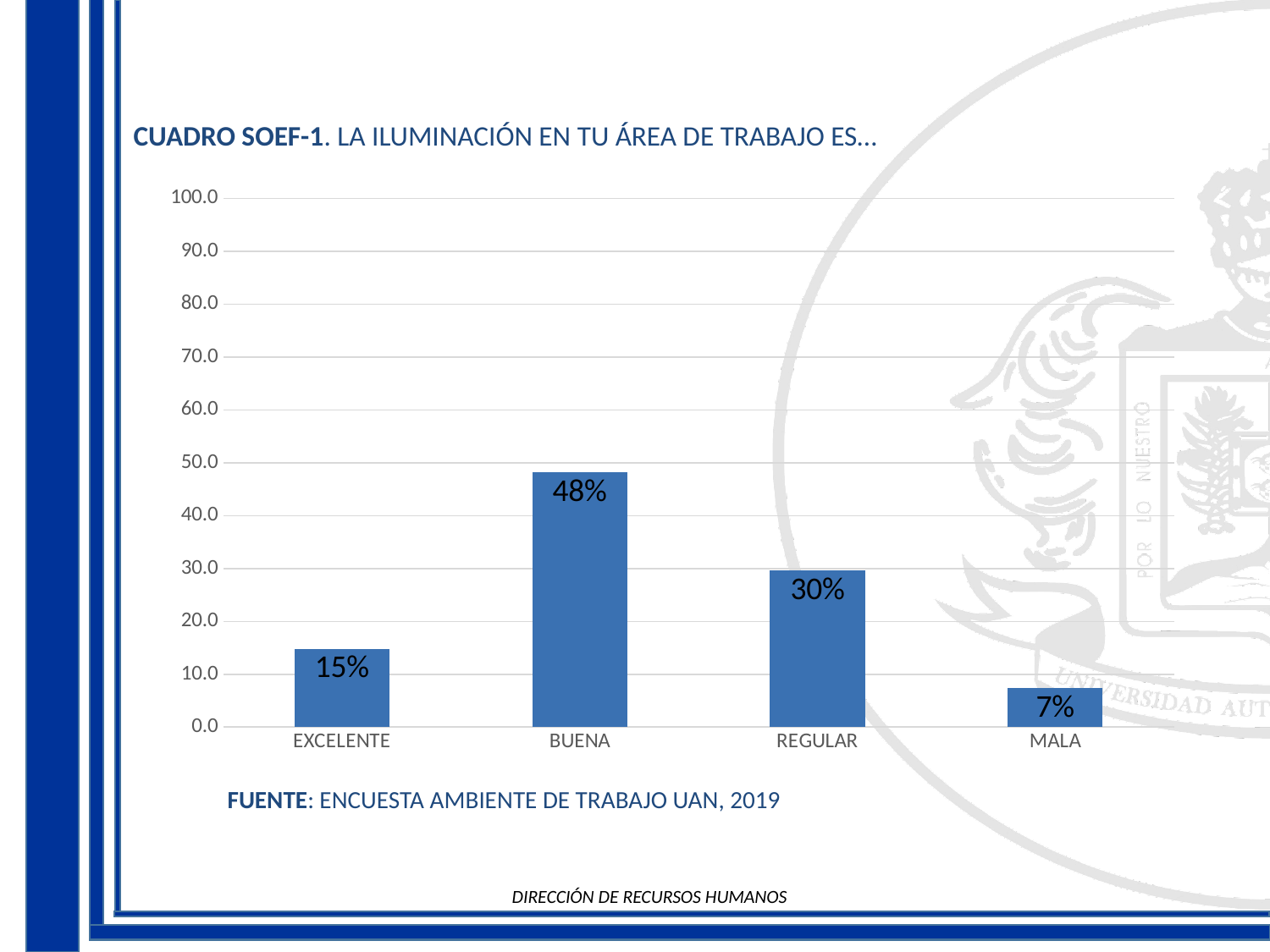
What is the value for MALA? 7% Which is larger, the value for EXCELENTE or the value for REGULAR? REGULAR What is the value for EXCELENTE? 15% What kind of chart is shown on the slide? bar chart Which category has the highest value? BUENA Is the value for BUENA greater or less than 50.0? less What is the value for BUENA? 48% Which category has the lowest value? MALA What is the value for REGULAR? 30% How many categories are shown on the x axis? 4 What is the difference between the values for BUENA and REGULAR? 18% What source is cited below the chart? ENCUESTA AMBIENTE DE TRABAJO UAN, 2019